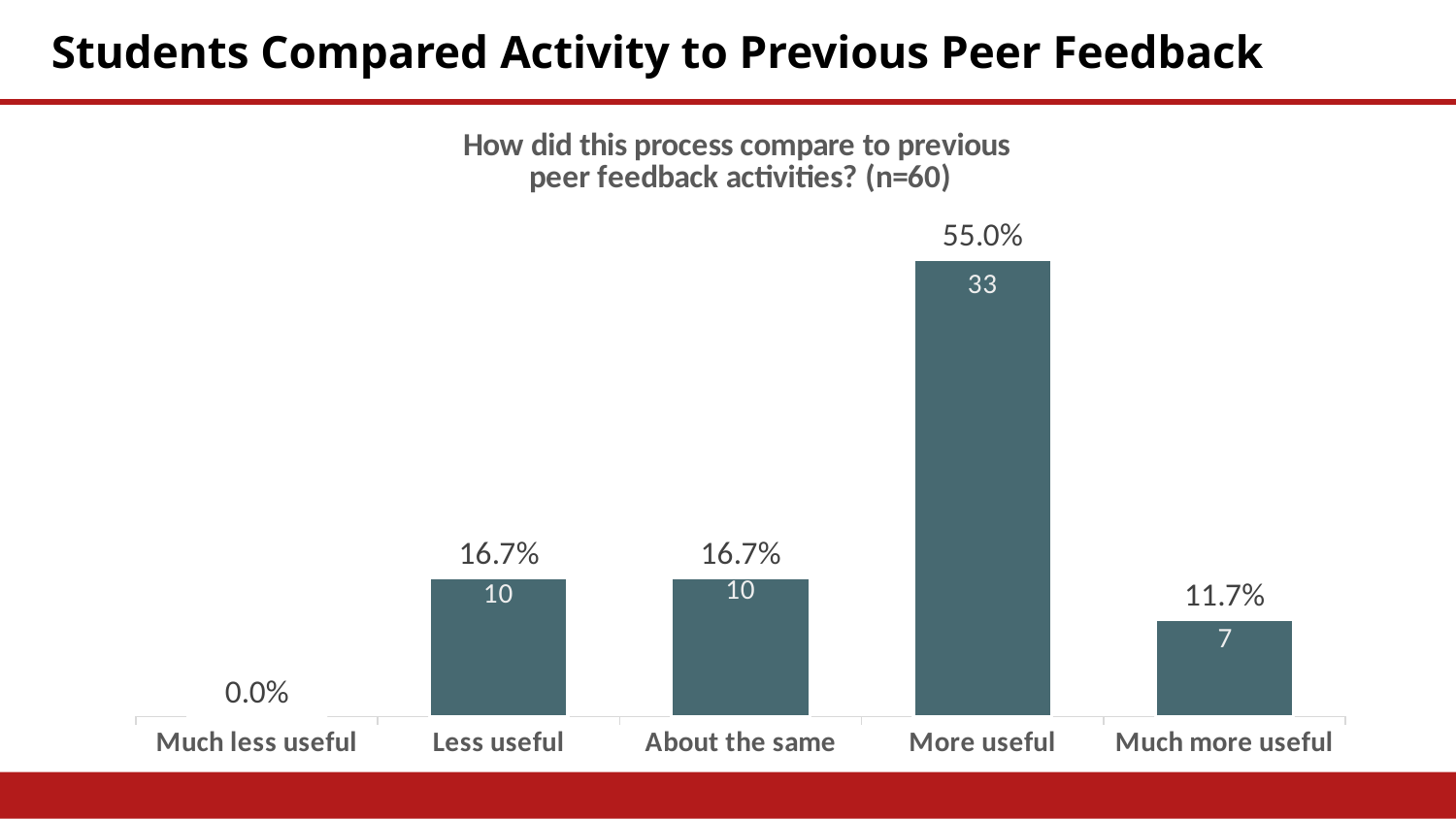
What type of chart is shown on the slide? Bar chart What percentage of students answered "Less useful"? 16.7% Which has a higher percentage, "Less useful" or "Much more useful"? Less useful What is the title of the chart? How did this process compare to previous peer feedback activities? (n=60) Which response category has the lowest percentage? Much less useful What percentage of students answered "More useful"? 55.0% How many students answered "Much more useful"? 7 What is the difference in percentage points between "More useful" and "Much more useful"? 43.3% How many more students answered "More useful" than "About the same"? 23 Which response category has the highest percentage? More useful How many response categories are shown on the x axis? 5 What percentage of students answered "Much less useful"? 0.0%